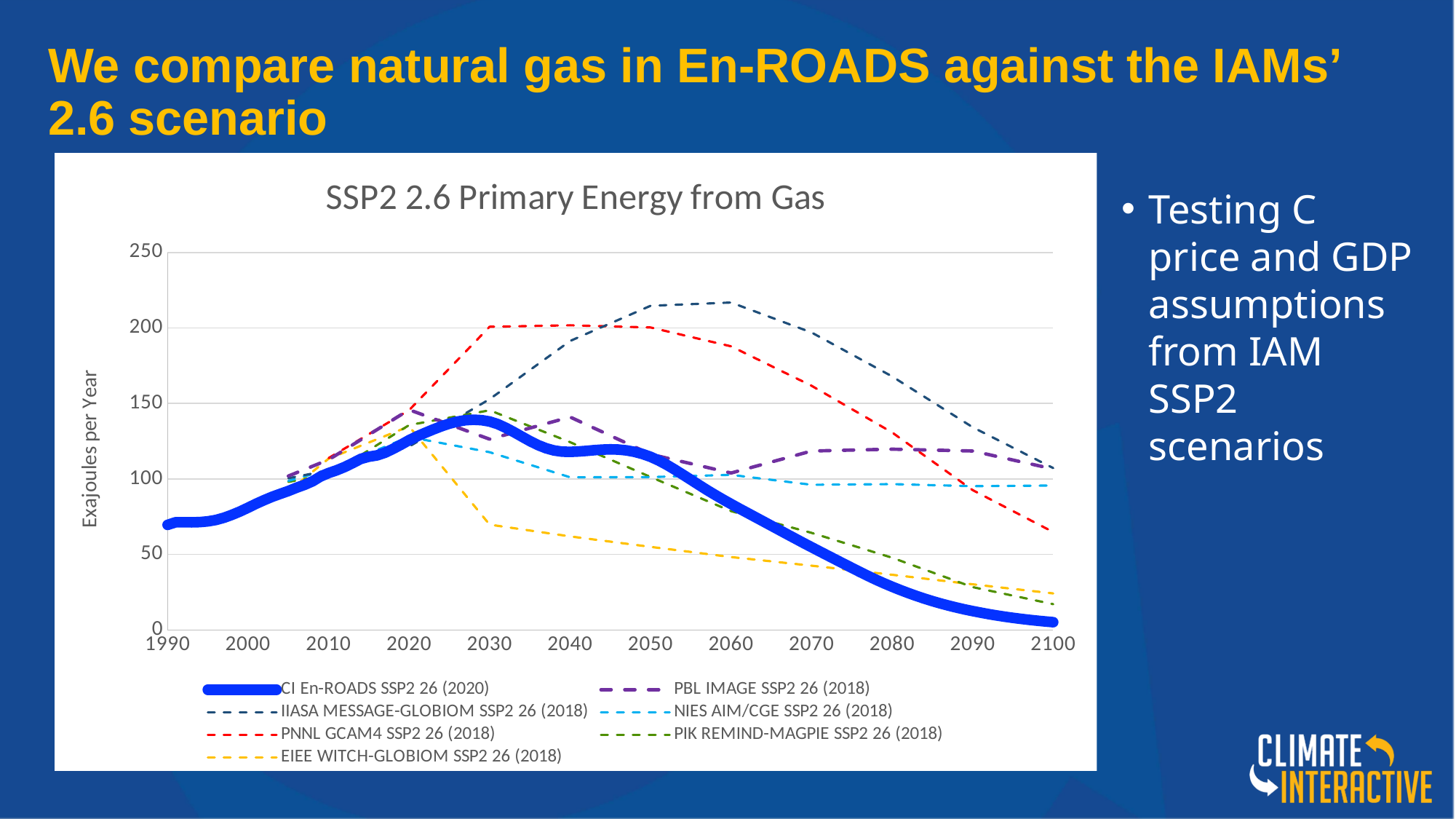
How many series does the legend list? 7 Is the peak value of IIASA MESSAGE-GLOBIOM SSP2 26 (2018) greater or less than 200? greater What kind of chart is shown on the slide? line chart Does the CI En-ROADS SSP2 26 (2020) line rise or fall from 2030 to 2100? fall Which series reaches the highest value anywhere on the chart? IIASA MESSAGE-GLOBIOM SSP2 26 (2018) Which series is drawn as the thick solid blue line? CI En-ROADS SSP2 26 (2020) What is the title of the chart? SSP2 2.6 Primary Energy from Gas In 2100, which is higher: PBL IMAGE SSP2 26 (2018) or CI En-ROADS SSP2 26 (2020)? PBL IMAGE SSP2 26 (2018) Is the value for EIEE WITCH-GLOBIOM SSP2 26 (2018) in 2030 greater or less than 100? less Which series has the lowest value in 2100? CI En-ROADS SSP2 26 (2020) Is the value for CI En-ROADS SSP2 26 (2020) in 2100 greater or less than 50? less